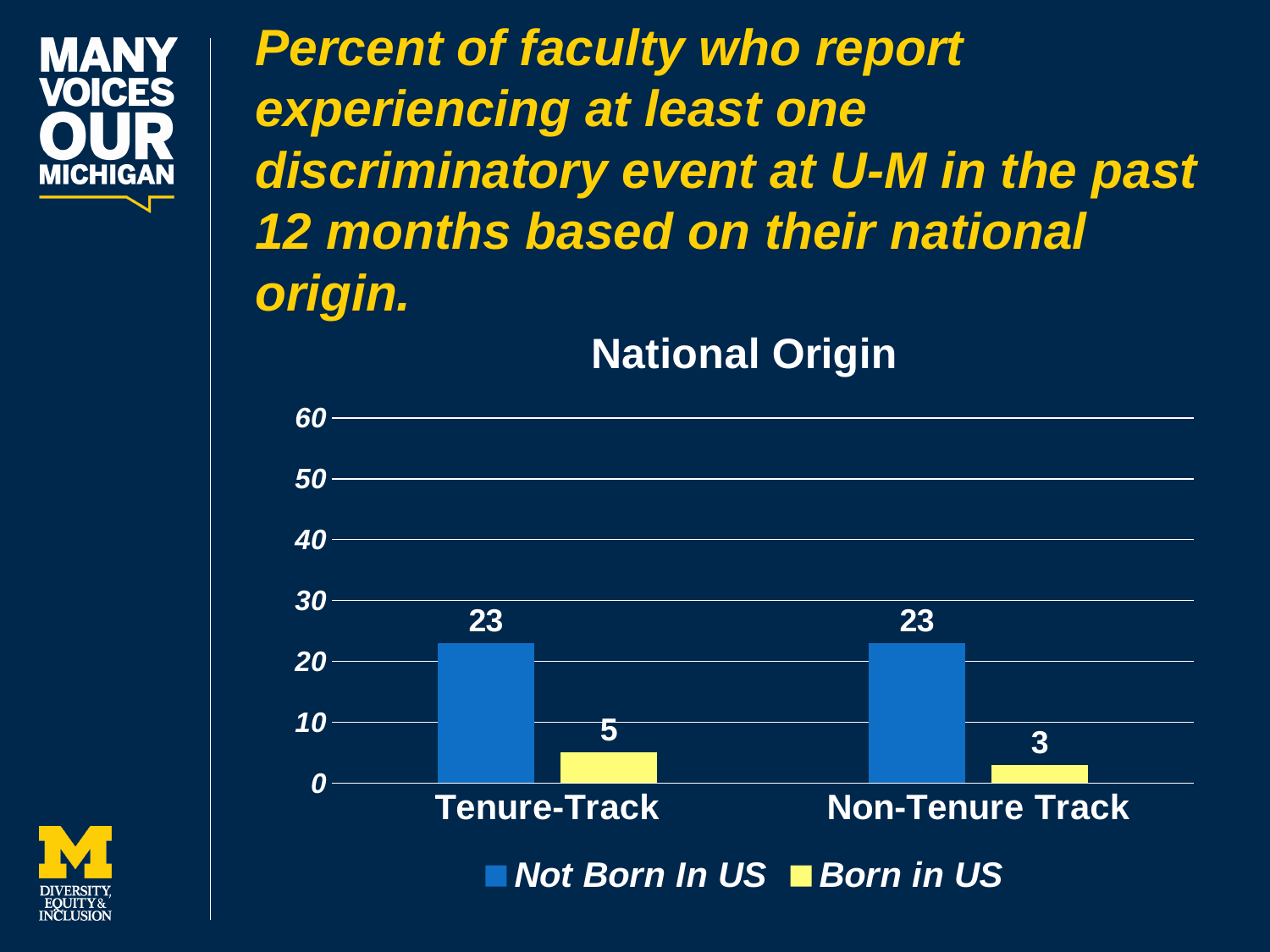
Which category has the lowest value for the Born in US series? Non-Tenure Track What is the difference between the Not Born In US and Born in US values in the Tenure-Track category? 18 How many series does the legend list? 2 What is the value for Born in US faculty in the Tenure-Track category? 5 What is the difference between the Not Born In US and Born in US values in the Non-Tenure Track category? 20 What kind of chart is shown on the slide? Bar chart What is the value for Born in US faculty in the Non-Tenure Track category? 3 What is the value for Not Born In US faculty in the Tenure-Track category? 23 Is the value for Not Born In US in the Tenure-Track category greater or less than 20? greater What is the title of the chart? National Origin How many categories are shown on the x axis? 2 Which is larger in the Non-Tenure Track category: Not Born In US or Born in US? Not Born In US